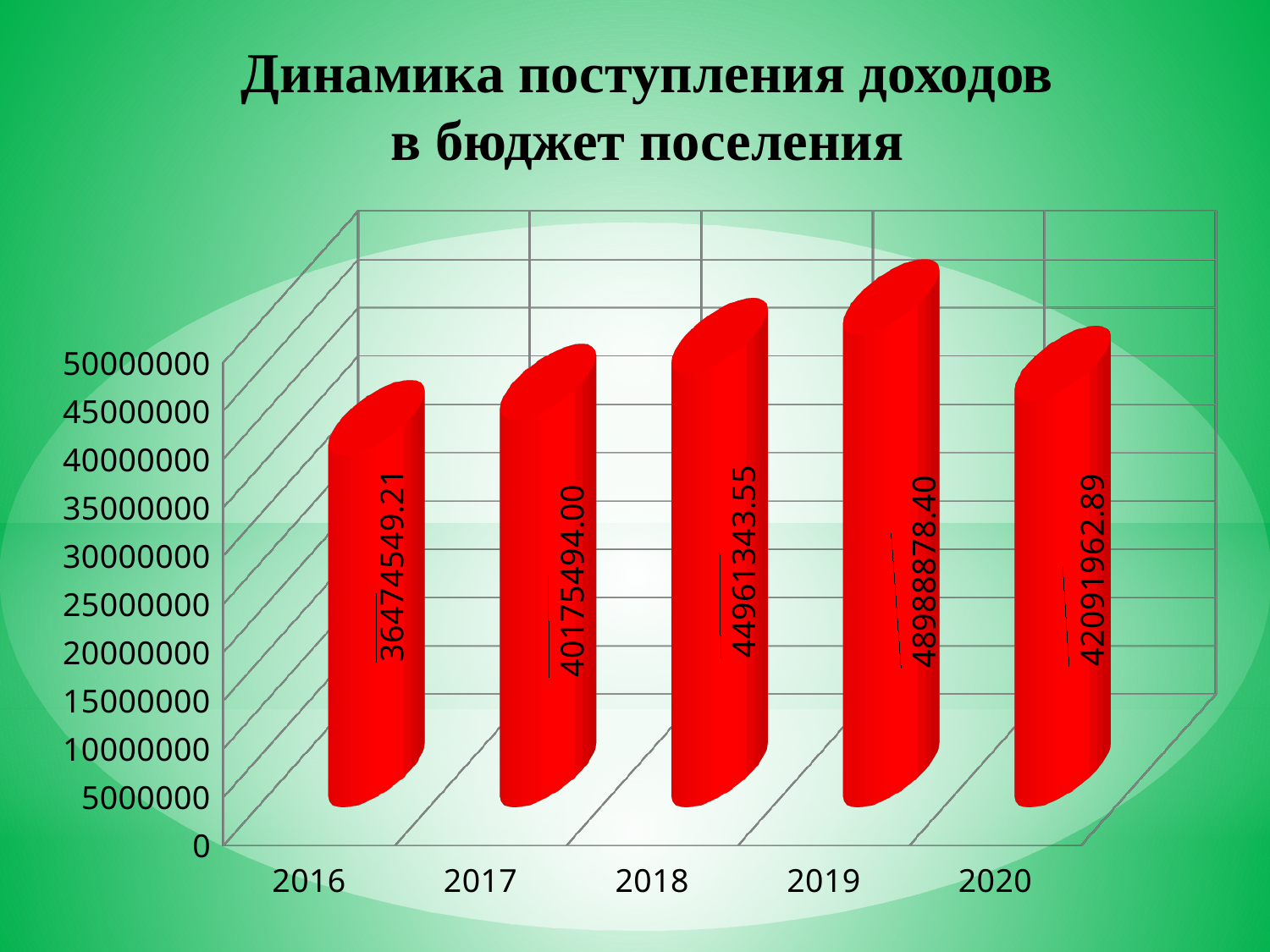
What is the value for 2016? 36474549.21 Which year has the highest value? 2019 What is the difference between the values for 2018 and 2017? 4785849.55 What is the value for 2018? 44961343.55 Do the values rise or fall from 2016 to 2019? rise What is the value for 2020? 42091962.89 How many years are shown on the x axis? 5 What kind of chart is shown on the slide? bar chart Which year has the lowest value? 2016 Which is larger, the value for 2017 or the value for 2020? 2020 What is the difference between the values for 2019 and 2016? 12514329.19 Is the value for 2019 greater or less than 45000000? greater